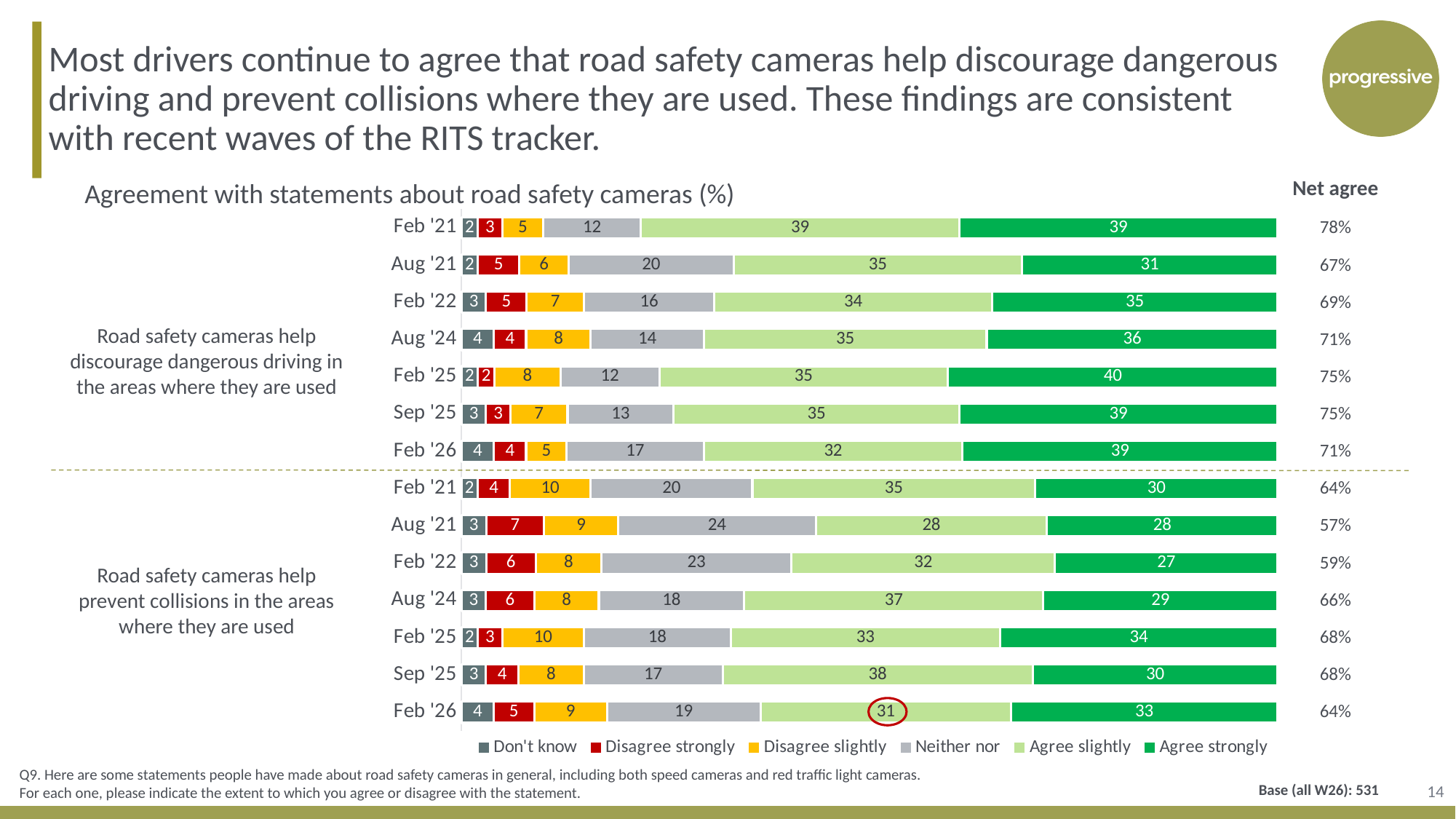
What is the Net agree figure for Feb '26 for the 'prevent collisions' statement? 64% For the 'discourage dangerous driving' statement, what is the combined total of 'Agree slightly' and 'Agree strongly' for Feb '26? 71 How many waves (bars) are shown for each statement? 7 For the 'discourage dangerous driving' statement, which wave has the highest Net agree figure? Feb '21 For the statement 'Road safety cameras help discourage dangerous driving in the areas where they are used', what is the 'Agree strongly' value for Feb '25? 40 Which value on the chart is circled in red? 31 (Agree slightly, Feb '26, prevent collisions) For the 'prevent collisions' statement, which wave has the lowest Net agree figure? Aug '21 For the statement 'Road safety cameras help prevent collisions in the areas where they are used', what is the 'Neither nor' value for Aug '21? 24 What kind of chart is shown on the slide? Stacked bar chart For the 'prevent collisions' statement, which is larger for Sep '25: 'Agree slightly' or 'Agree strongly'? Agree slightly For the 'discourage dangerous driving' statement, what is the difference between the 'Agree strongly' values for Feb '25 and Aug '21? 9 How many series does the legend list? 6